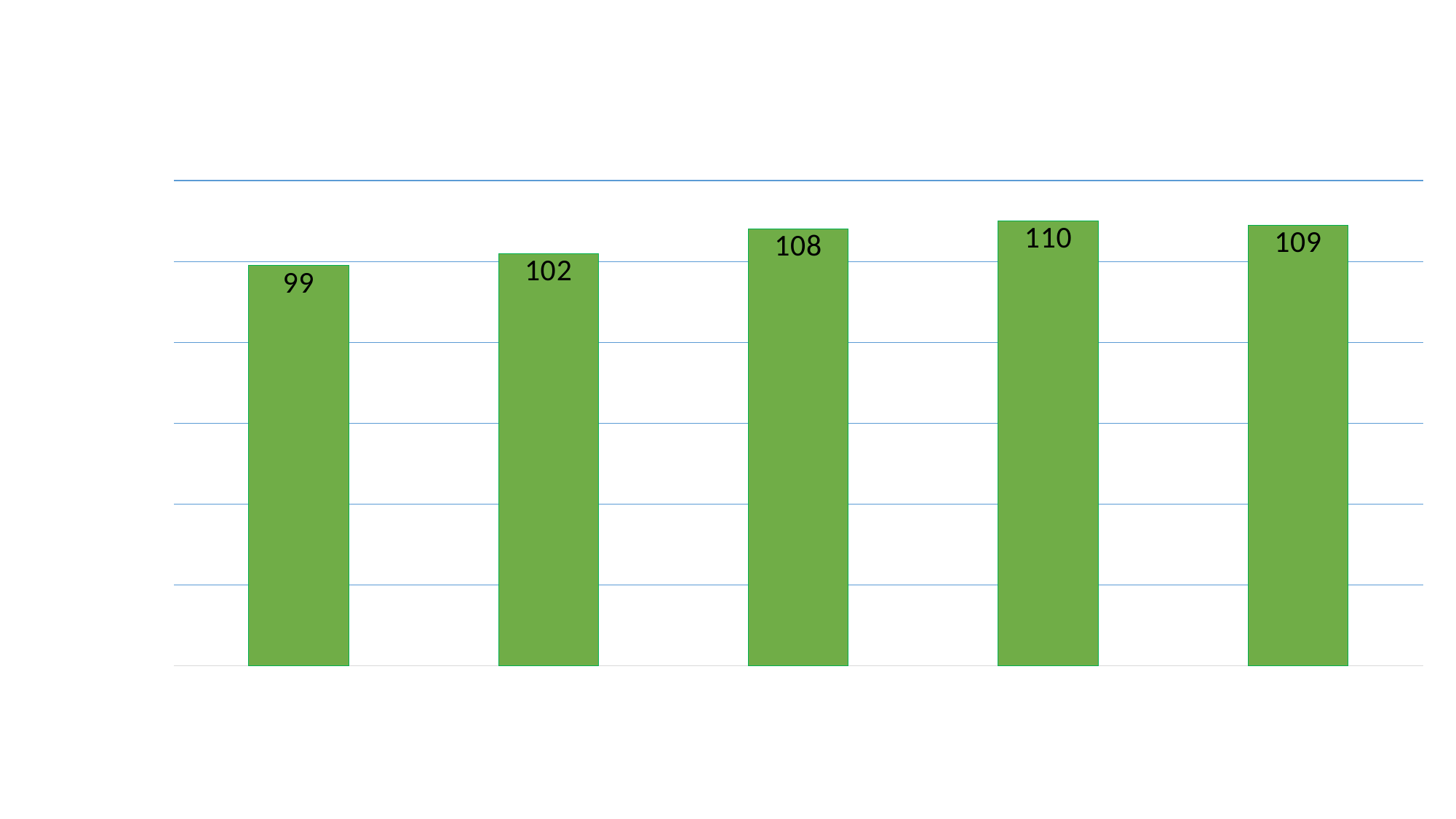
What is the value of the second bar from the left? 102 What is the value of the last (rightmost) bar? 109 What is the difference between the highest bar (110) and the lowest bar (99)? 11 Which is larger, the value of the fourth bar or the value of the fifth bar? the fourth bar (110) What is the lowest value shown in the chart? 99 How many bars are plotted in the chart? 5 What kind of chart is shown on the slide? bar chart What is the value of the third bar from the left? 108 Do the values rise or fall from the first bar to the fourth bar? rise What is the highest value shown in the chart? 110 What is the value of the fourth bar from the left? 110 What is the value of the first (leftmost) bar? 99